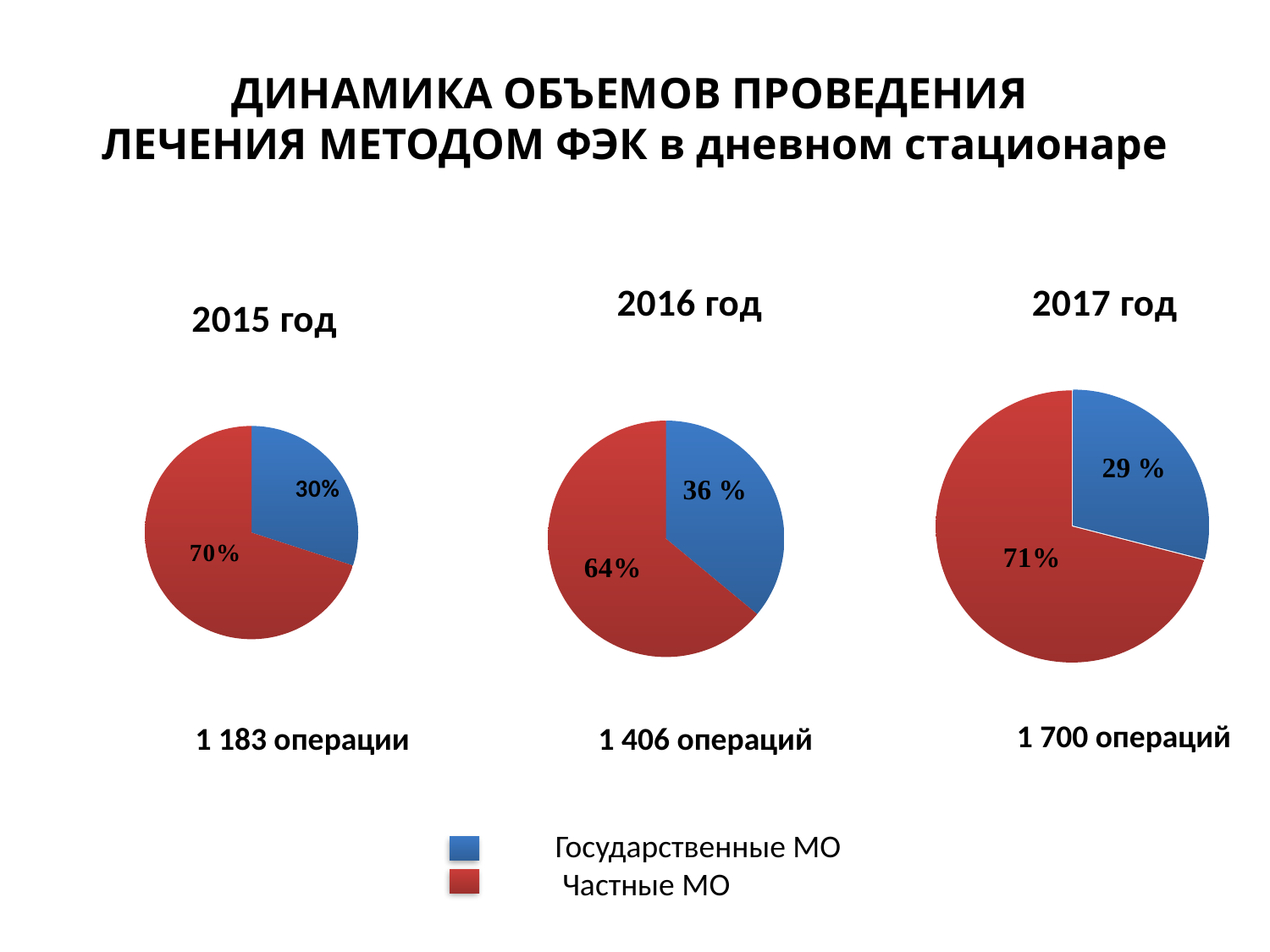
In the 2017 год pie chart, what share is shown for Частные МО? 71% In the 2015 год pie chart, what share is shown for Государственные МО? 30% In the 2017 год pie chart, which category has the smaller slice? Государственные МО In the 2016 год pie chart, what share is shown for Частные МО? 64% What total number of operations is shown under the 2017 год pie chart? 1 700 операций In the 2015 год pie chart, what share is shown for Частные МО? 70% In the 2016 год pie chart, what share is shown for Государственные МО? 36 % What kind of charts are shown on the slide? Pie charts In the 2016 год pie chart, which category has the larger slice? Частные МО In the 2017 год pie chart, what share is shown for Государственные МО? 29 % How many categories does the legend list? 2 In the 2015 год pie chart, what is the difference in percentage points between the Частные МО and Государственные МО slices? 40